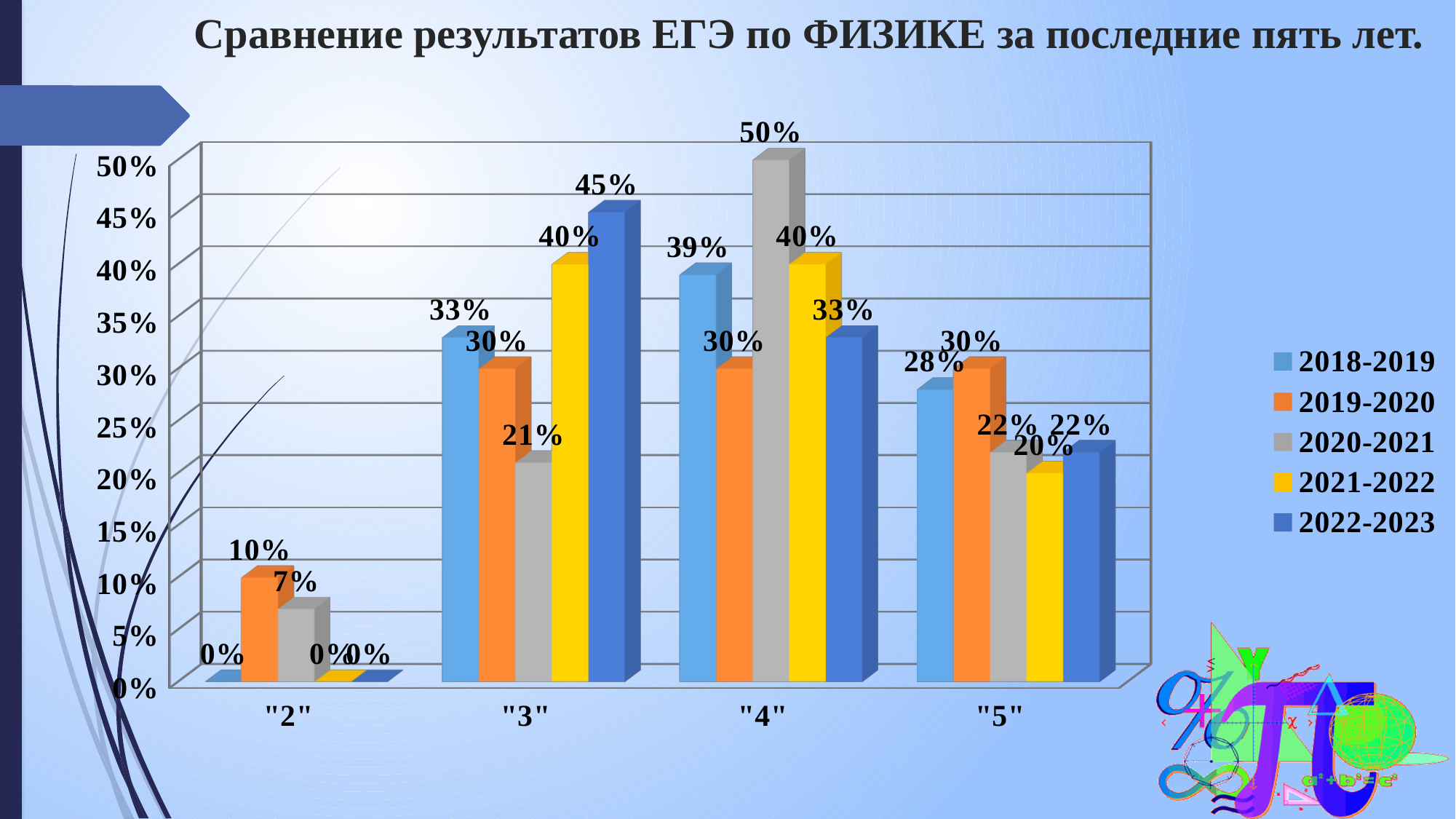
What is the value for 2021-2022 in category "5"? 20% Which is larger in category "5": the value for 2018-2019 or the value for 2019-2020? 2019-2020 What is the difference between the 2022-2023 value and the 2020-2021 value in category "3"? 24% What is the title of the chart? Сравнение результатов ЕГЭ по ФИЗИКЕ за последние пять лет. Which series has the lowest value in category "3"? 2020-2021 How many categories are shown on the x axis? 4 What is the value for 2019-2020 in category "2"? 10% What type of chart is shown on the slide? bar chart How many series does the legend list? 5 Which series has the highest value in category "4"? 2020-2021 What is the value for 2022-2023 in category "3"? 45% What is the value for 2020-2021 in category "4"? 50%